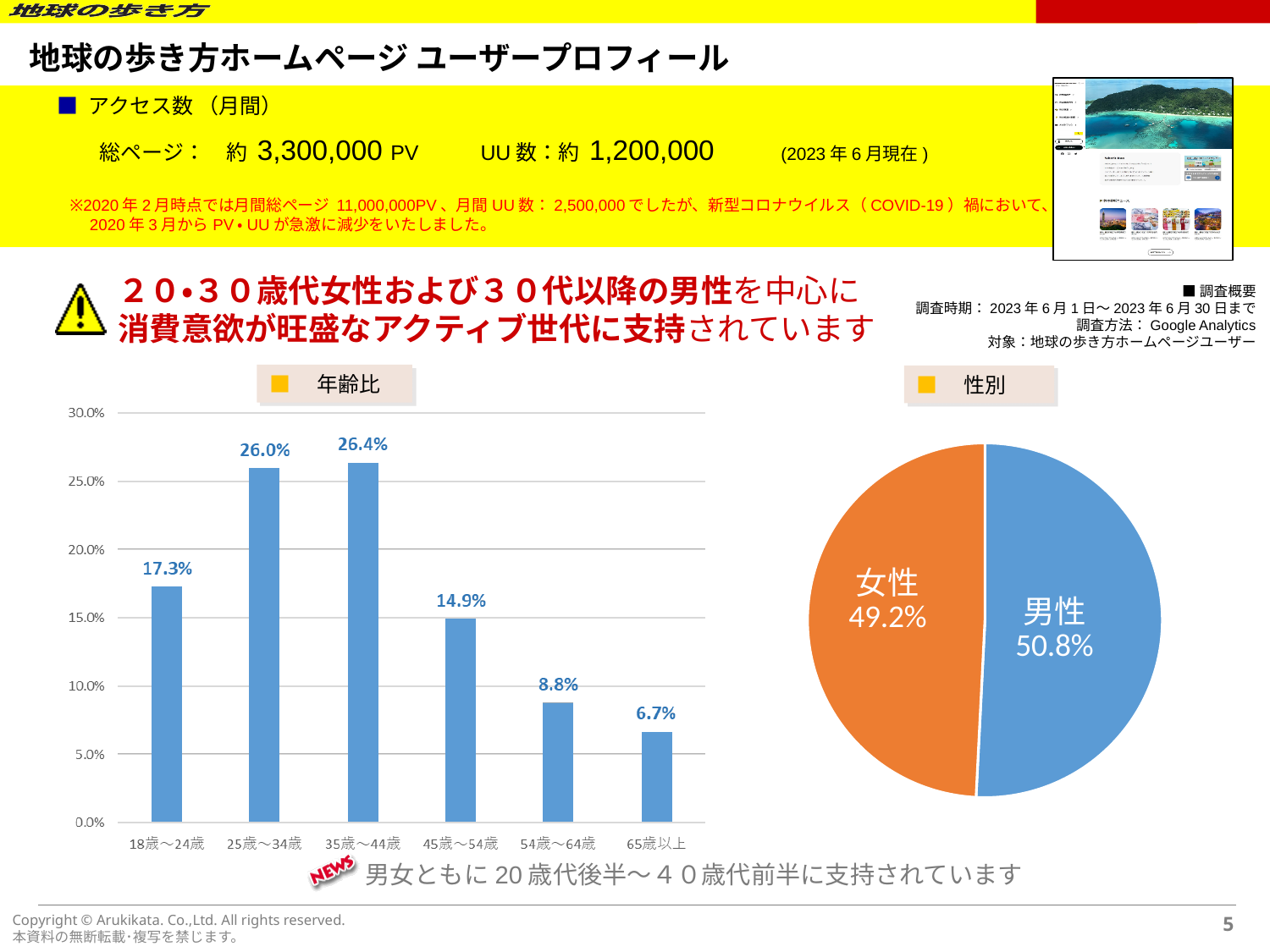
In the 性別 pie chart, what share is 男性? 50.8% In the 年齢比 bar chart, what is the difference between the values for 25歳〜34歳 and 54歳〜64歳? 17.2% In the 年齢比 bar chart, how many age groups are shown? 6 In the 年齢比 bar chart, which is larger, the value for 18歳〜24歳 or the value for 45歳〜54歳? 18歳〜24歳 In the 年齢比 bar chart, do the values rise or fall from 35歳〜44歳 to 65歳以上? Fall What kind of chart is the 年齢比 chart? Bar chart In the 性別 pie chart, what share is 女性? 49.2% In the 年齢比 bar chart, what is the value for 45歳〜54歳? 14.9% What kind of chart is the 性別 chart? Pie chart In the 年齢比 bar chart, which age group has the lowest value? 65歳以上 In the 年齢比 bar chart, what is the value for 18歳〜24歳? 17.3% In the 年齢比 bar chart, which age group has the highest value? 35歳〜44歳